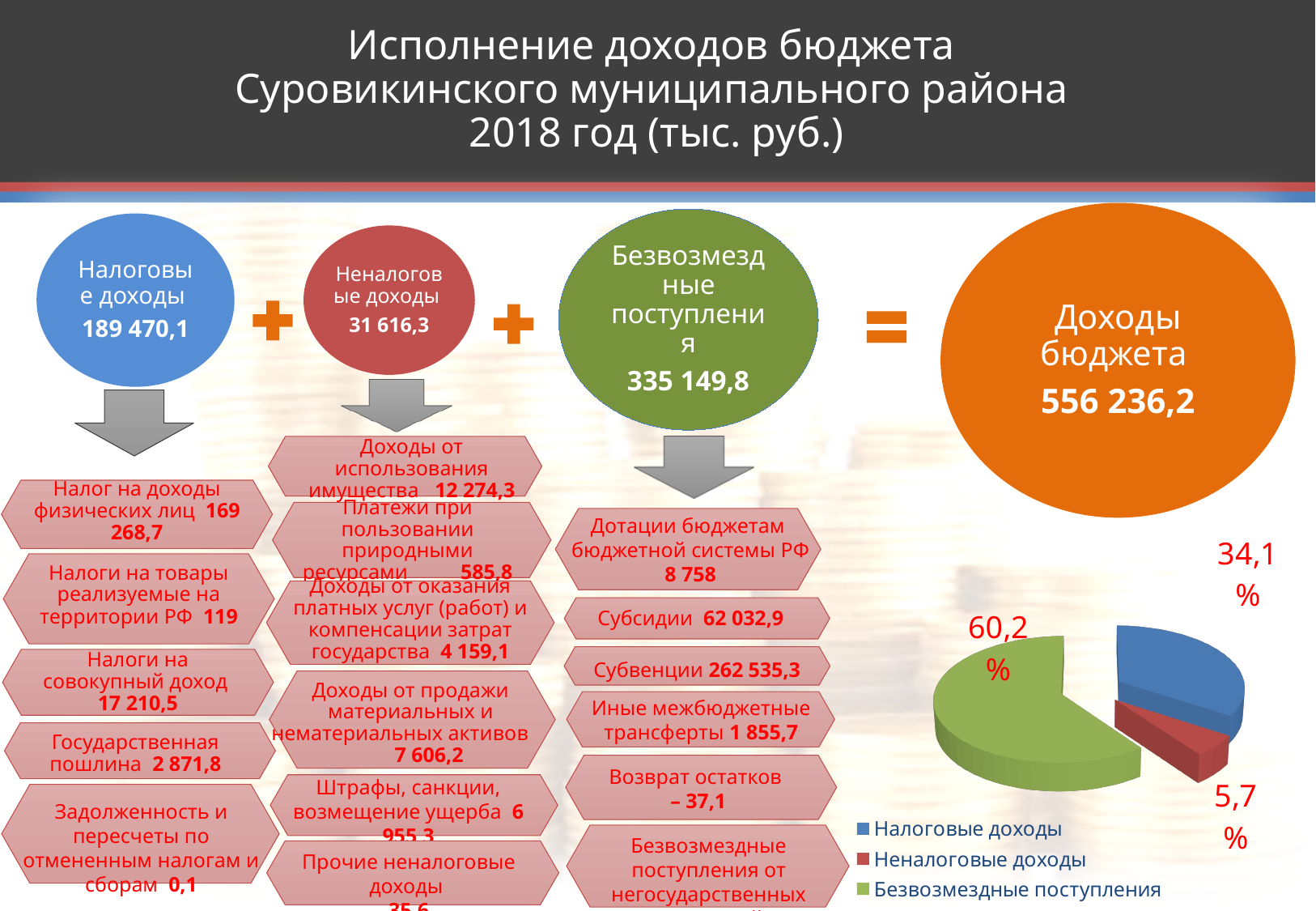
What kind of chart is shown at the bottom right of the slide? Pie chart In the pie chart, by how many percentage points does Безвозмездные поступления exceed Налоговые доходы? 26,1 What colour is the Безвозмездные поступления slice in the pie chart? Green In the pie chart, what share is shown for Неналоговые доходы? 5,7% In the pie chart, which is larger: Налоговые доходы or Неналоговые доходы? Налоговые доходы Which slice of the pie chart is the smallest? Неналоговые доходы How many slices does the pie chart have? 3 In the pie chart, by how many percentage points does Налоговые доходы exceed Неналоговые доходы? 28,4 In the pie chart, what share is shown for Безвозмездные поступления? 60,2% Which slice of the pie chart is the largest? Безвозмездные поступления In the pie chart, what share is shown for Налоговые доходы? 34,1% How many entries does the pie chart's legend list? 3